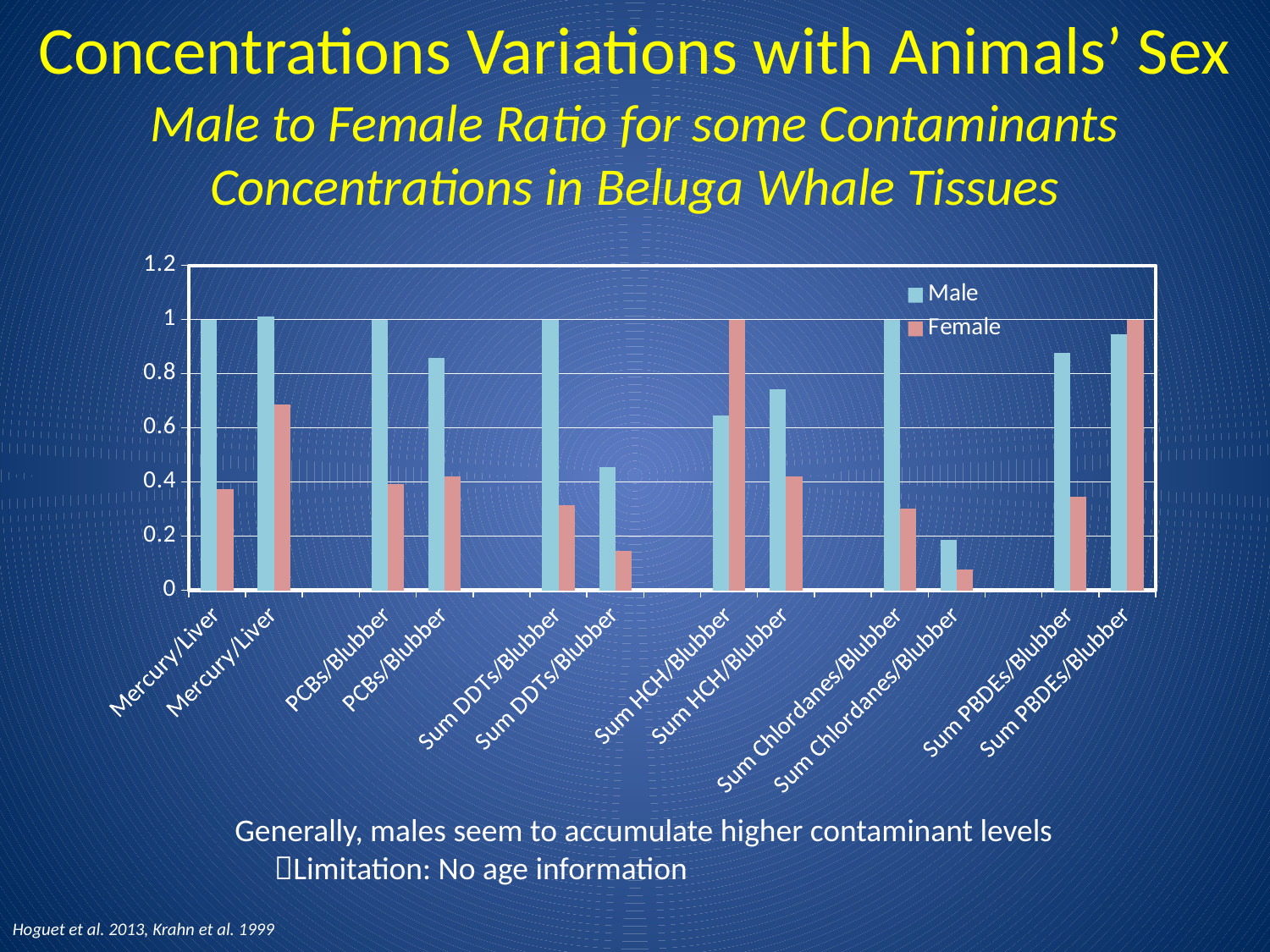
How many categories are shown along the x axis of the chart? 12 Is the Male value for the second Sum Chlordanes/Blubber category greater or less than 0.4? less Is the Female value for the second Mercury/Liver category greater or less than 0.6? greater In the first Mercury/Liver category, which is larger, the Male or the Female value? Male What is the Female value for the first Sum HCH/Blubber category? 1 What kind of chart is shown on the slide? bar chart In the first Sum HCH/Blubber category, which is larger, the Male or the Female value? Female What is the highest value shown on the chart's y axis? 1.2 What are the two series named in the chart's legend? Male and Female How many series does the chart's legend list? 2 What is the Male value for the first Mercury/Liver category? 1 Is the Female value for the second Sum DDTs/Blubber category greater or less than 0.2? less